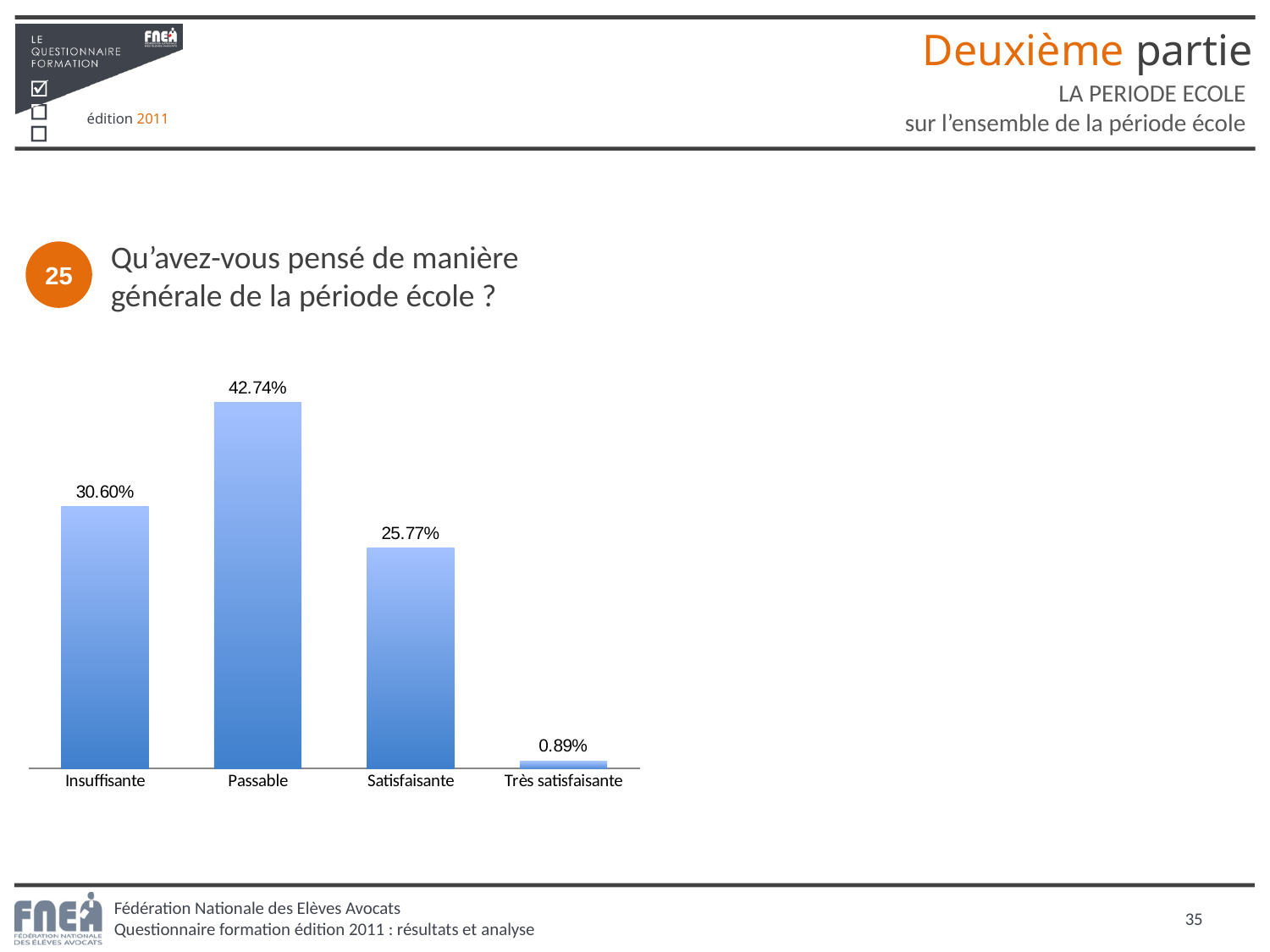
What is the difference between the values for Insuffisante and Satisfaisante? 4.83% What is the value for Passable? 42.74% What is the value for Très satisfaisante? 0.89% What is the value for Satisfaisante? 25.77% What is the difference between the values for Passable and Insuffisante? 12.14% Which category has the lowest value? Très satisfaisante What kind of chart is shown on the slide? Bar chart How many categories are shown in the chart? 4 What is the value for Insuffisante? 30.60% Which category has the highest value? Passable Which is larger, the value for Insuffisante or the value for Satisfaisante? Insuffisante What is the number of the survey question shown next to the chart? 25